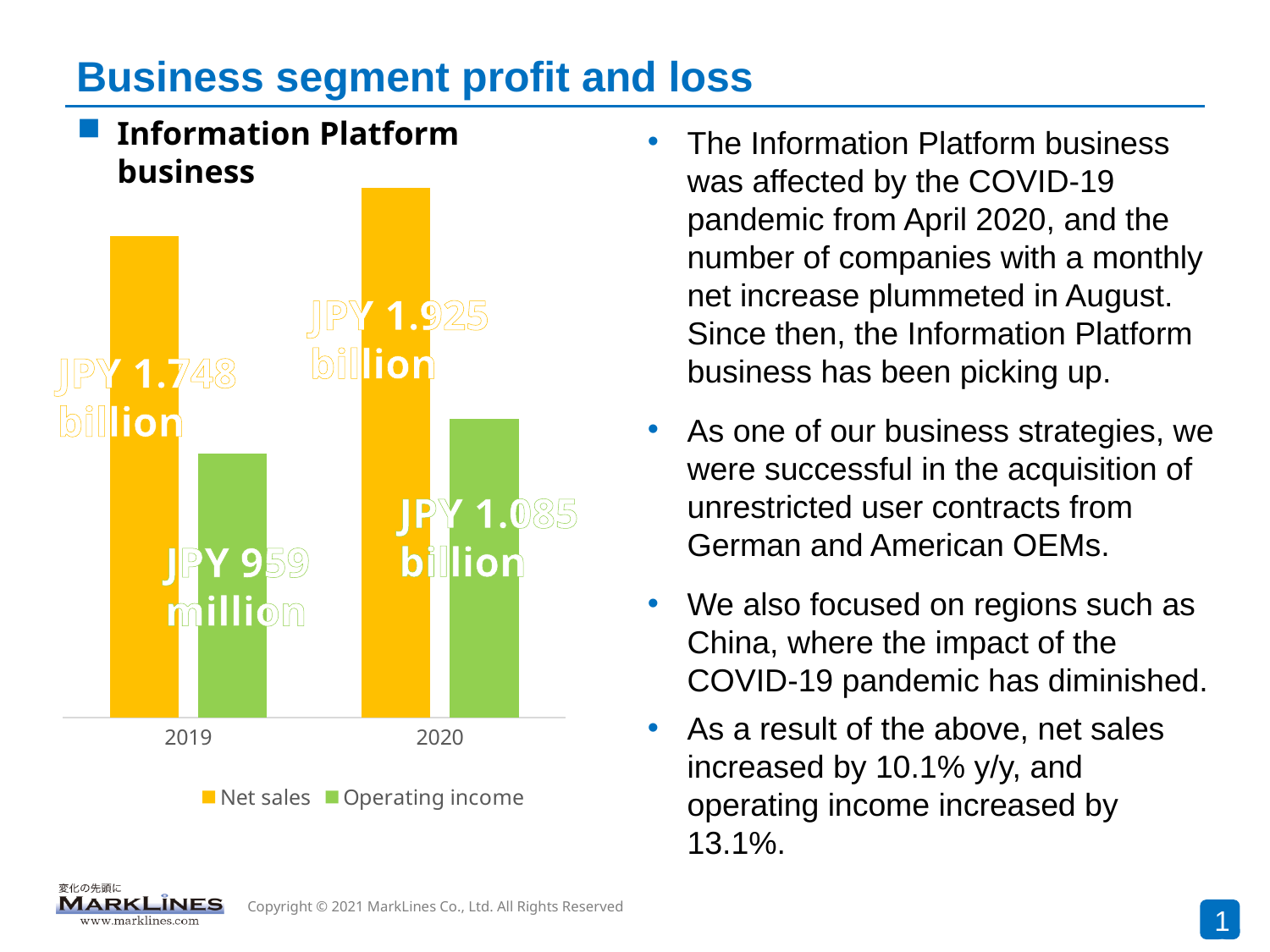
Which colour represents Operating income in the chart? green What type of chart is shown on the slide? bar chart By how much did Net sales increase from 2019 to 2020? JPY 0.177 billion What is the Operating income value for 2019? JPY 959 million What is the Operating income value for 2020? JPY 1.085 billion How many years are shown on the x axis of the chart? 2 How many series does the chart legend list? 2 Is Net sales in 2020 larger or smaller than Net sales in 2019? larger What is the Net sales value for 2019? JPY 1.748 billion What is the Net sales value for 2020? JPY 1.925 billion Which year has the lower Operating income? 2019 Which year has the higher Net sales? 2020